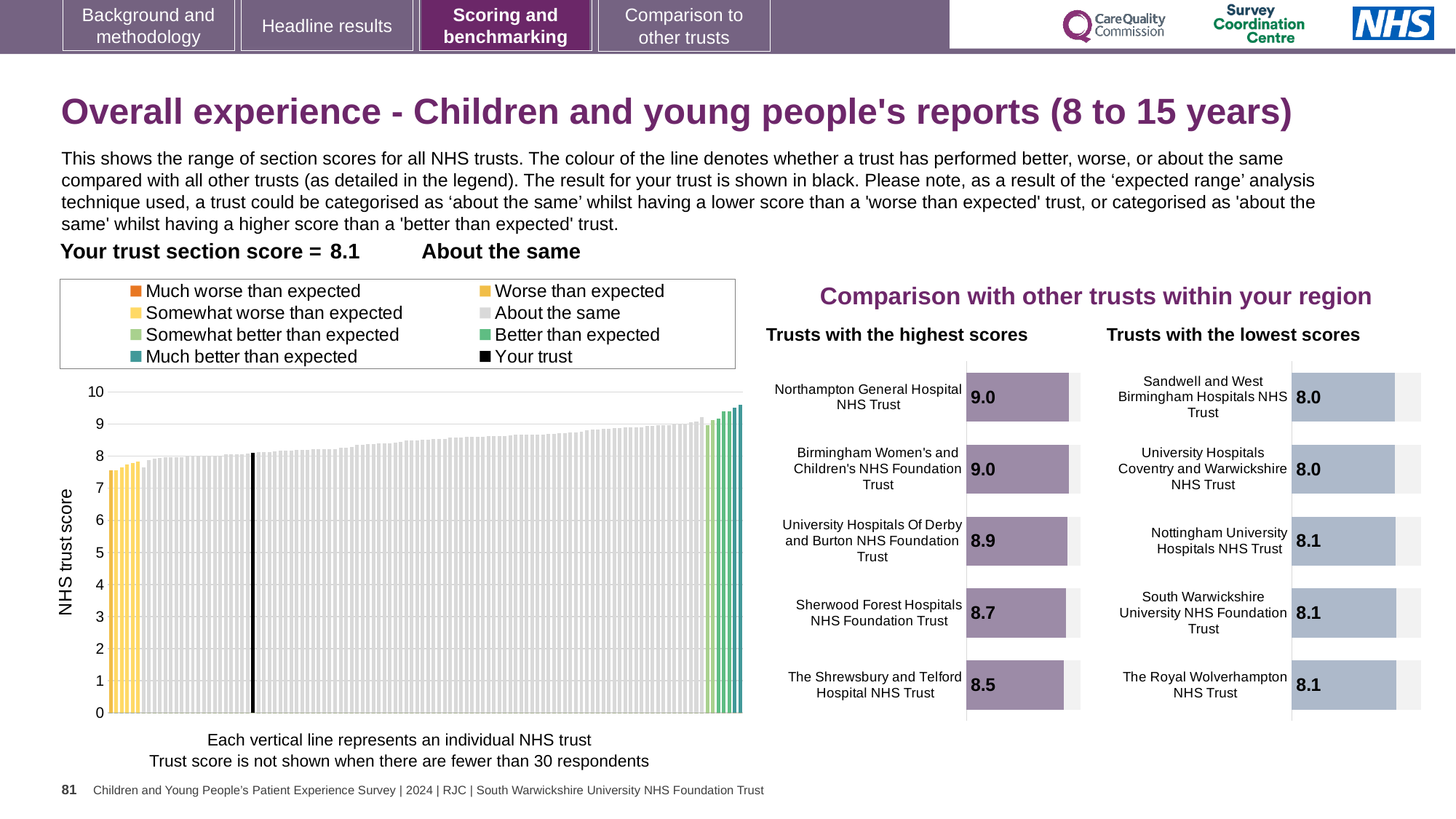
In the 'Trusts with the highest scores' chart, what is the score for Northampton General Hospital NHS Trust? 9.0 In the main 'NHS trust score' chart, how many entries does the legend list? 8 In the 'Trusts with the highest scores' chart, what is the score for Sherwood Forest Hospitals NHS Foundation Trust? 8.7 How many trusts are shown in the 'Trusts with the lowest scores' chart? 5 In the 'Trusts with the highest scores' chart, which has the larger score: University Hospitals Of Derby and Burton NHS Foundation Trust or Sherwood Forest Hospitals NHS Foundation Trust? University Hospitals Of Derby and Burton NHS Foundation Trust In the 'Trusts with the lowest scores' chart, what is the score for Nottingham University Hospitals NHS Trust? 8.1 In the 'Trusts with the highest scores' chart, what is the difference between the scores of Northampton General Hospital NHS Trust and The Shrewsbury and Telford Hospital NHS Trust? 0.5 In the main 'NHS trust score' chart, is the value for the black 'Your trust' bar greater or less than 5? greater What kind of chart is the main 'NHS trust score' chart on the left? Bar chart In the main 'NHS trust score' chart, do the trust scores rise or fall from left to right? Rise In the 'Trusts with the lowest scores' chart, what is the score for Sandwell and West Birmingham Hospitals NHS Trust? 8.0 In the 'Trusts with the highest scores' chart, which trust has the lowest score? The Shrewsbury and Telford Hospital NHS Trust